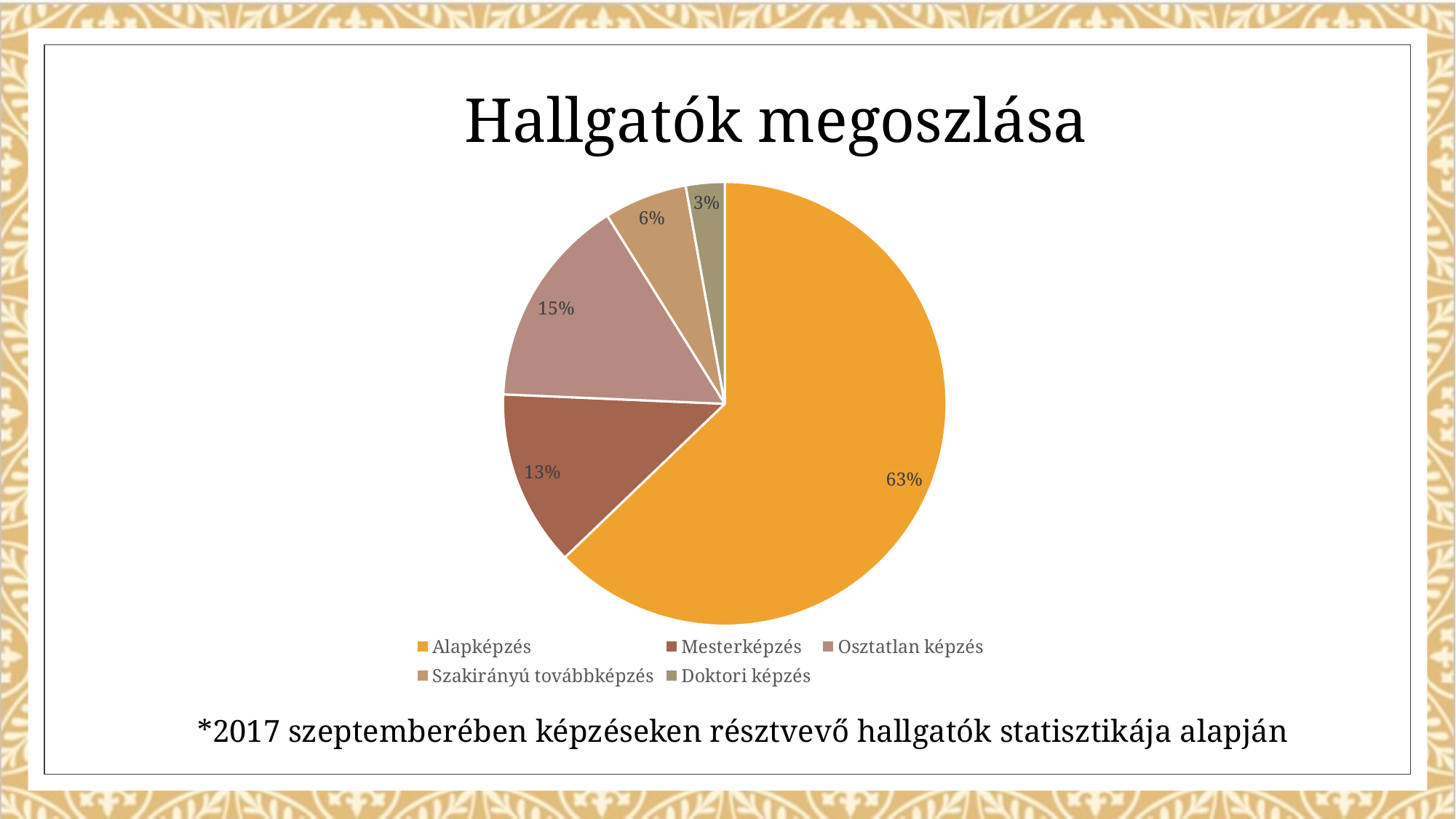
How many categories does the pie chart show? 5 What is the title of the chart? Hallgatók megoszlása What kind of chart is shown on the slide? Pie chart Which category has the largest slice of the pie? Alapképzés What share of the pie does Osztatlan képzés have? 15% Which is larger, the share of Mesterképzés or the share of Osztatlan képzés? Osztatlan képzés What share of the pie does Doktori képzés have? 3% What is the difference between the shares of Alapképzés and Osztatlan képzés? 48% What share of the pie does Alapképzés have? 63% Which category has the smallest slice of the pie? Doktori képzés